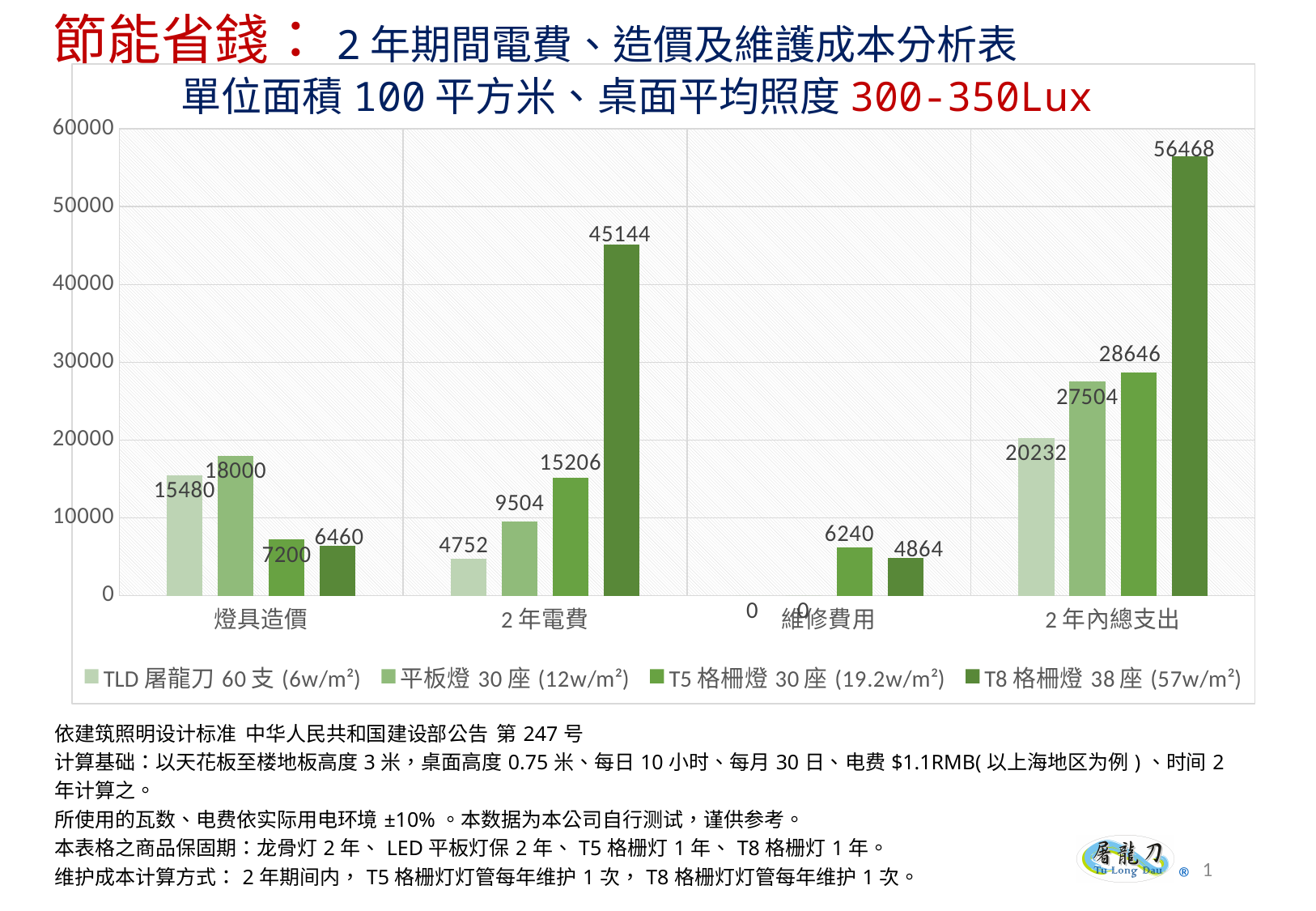
What is the 燈具造價 value for TLD 屠龍刀 60支 (6w/m²)? 15480 What is the difference between the 2年內總支出 of T8 格柵燈 38座 and TLD 屠龍刀 60支? 36236 How many series does the legend list? 4 What kind of chart is shown on the slide? bar chart Is the 2年電費 value for T8 格柵燈 38座 greater or less than 40000? greater What is the difference between the 2年電費 of T8 格柵燈 38座 and 平板燈 30座? 35640 What is the value for T8 格柵燈 38座 (57w/m²) in the 2年內總支出 category? 56468 Which series has the highest value in the 2年電費 category? T8 格柵燈 38座 (57w/m²) Which series has the lowest 燈具造價? T8 格柵燈 38座 (57w/m²) What is the 維修費用 value for T5 格柵燈 30座 (19.2w/m²)? 6240 How many categories are shown on the x axis? 4 In the 2年內總支出 category, which is larger: 平板燈 30座 or T5 格柵燈 30座? T5 格柵燈 30座 (19.2w/m²)